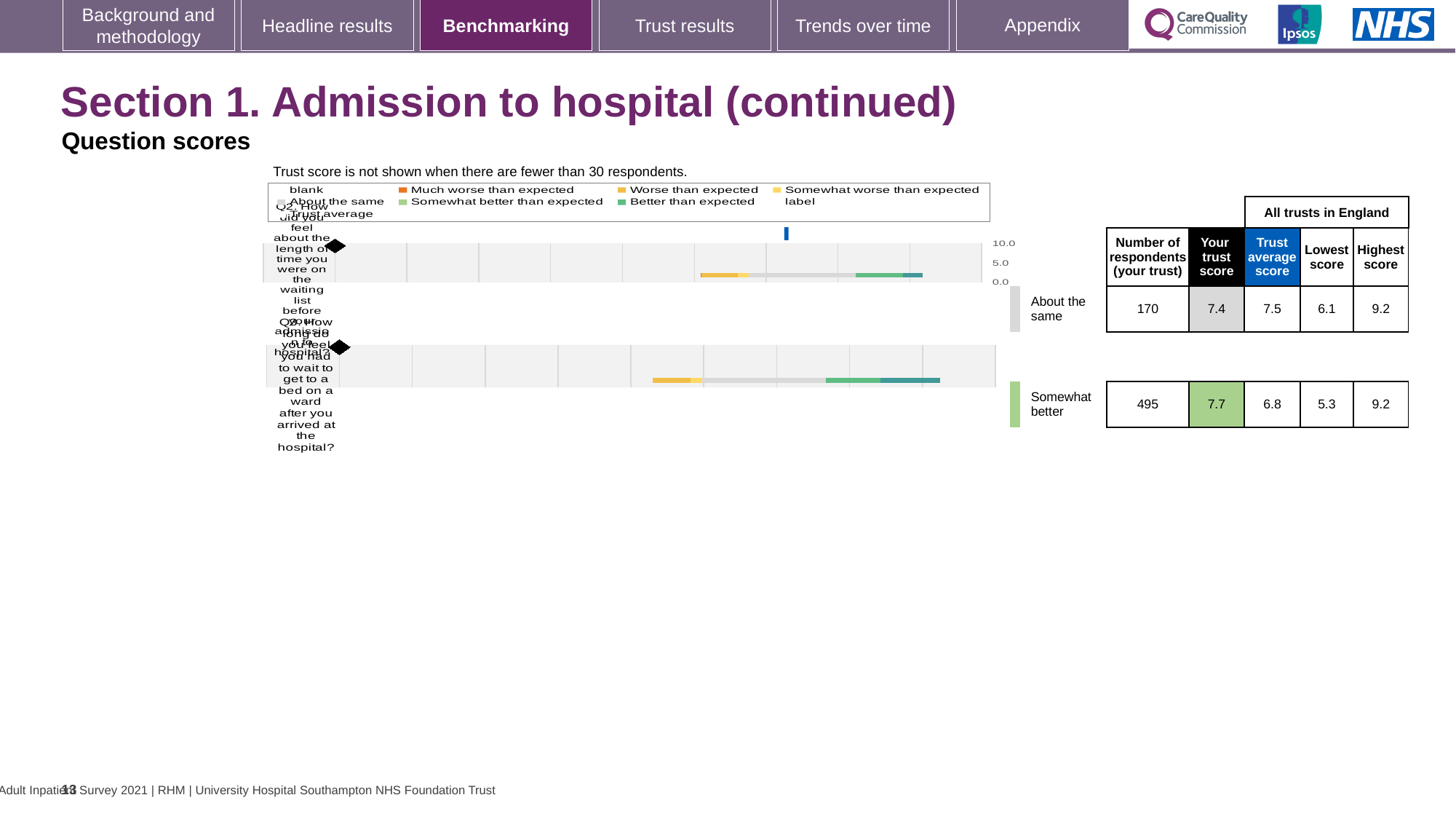
What is the trust score for Q3 (how long did you have to wait to get to a bed on a ward) shown on the slide? 7.7 How many questions (Q2 and Q3) are plotted in the benchmarking charts on this slide? 2 What kind of chart is used to show the question scores on this slide? bar chart Which legend entry is shown in orange in the chart legend? Much worse than expected How many respondents answered Q3 for this trust? 495 What is the highest tick value shown on the score axis of the charts? 10.0 What is the difference in the number of respondents between Q3 and Q2? 325 Which is larger for Q3: the trust's own score or the all-trusts average score? the trust's own score What benchmark category is Q3 placed in on this slide? Somewhat better What is the trust average score for Q2 across all trusts in England? 7.5 What is the trust score for Q2 (how did you feel about the length of time on the waiting list) shown on the slide? 7.4 What is the difference between the trust score and the trust average score for Q3? 0.9